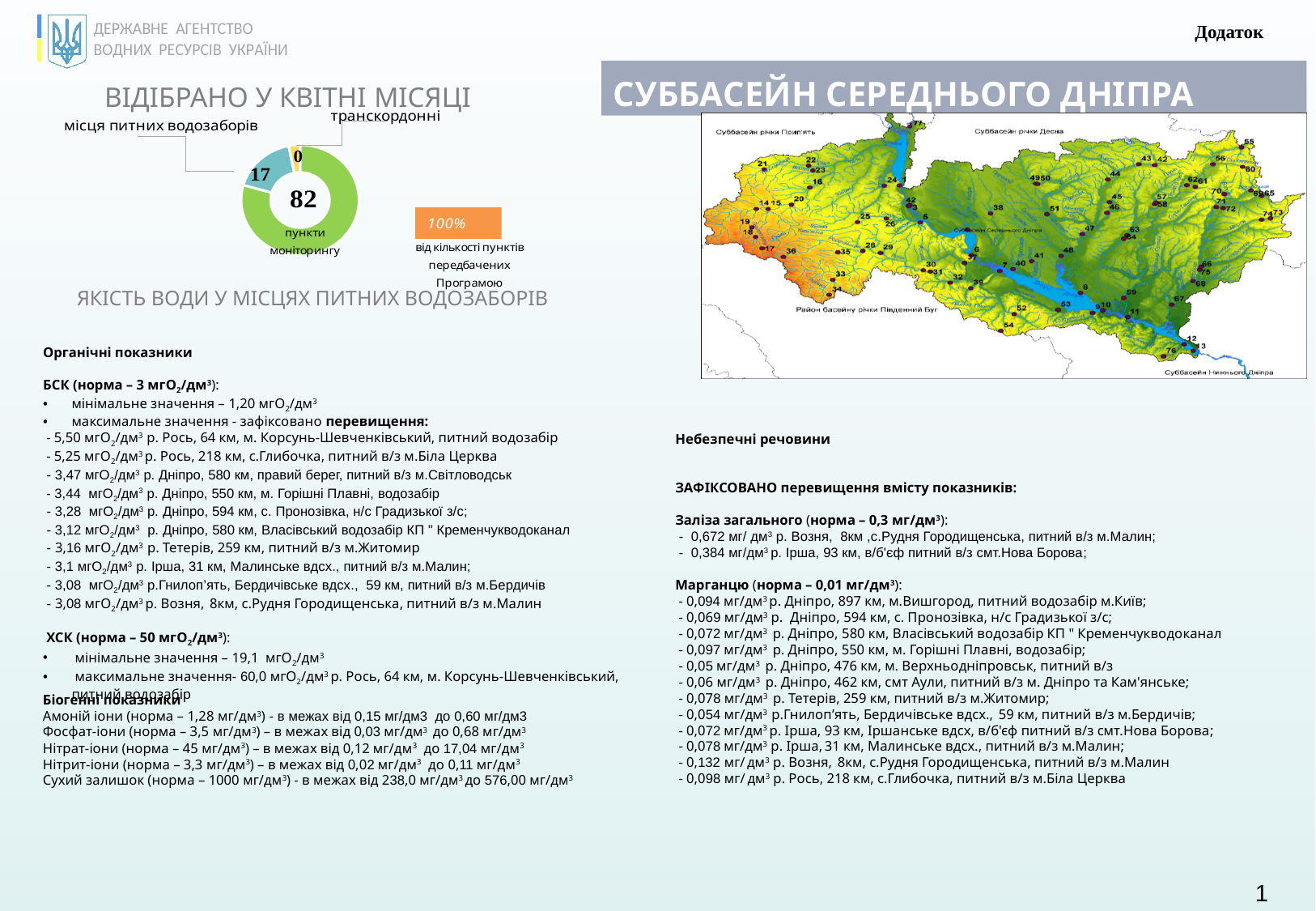
What is the title above the doughnut chart? ВІДІБРАНО У КВІТНІ МІСЯЦІ In the doughnut chart, what value is shown for "місця питних водозаборів"? 17 What kind of chart is shown under the heading "ВІДІБРАНО У КВІТНІ МІСЯЦІ"? Doughnut (pie) chart What number is printed in the centre of the doughnut chart? 82 What is the difference between the values for "місця питних водозаборів" and "транскордонні" in the doughnut chart? 17 In the doughnut chart, what value is shown for "транскордонні"? 0 What label accompanies the number 82 in the centre of the doughnut chart? пункти моніторингу How many slices does the doughnut chart contain? 3 Which has the larger value in the doughnut chart: "місця питних водозаборів" or "транскордонні"? місця питних водозаборів What percentage is shown in the orange box next to the doughnut chart? 100% Which labelled category in the doughnut chart has the lowest value? транскордонні